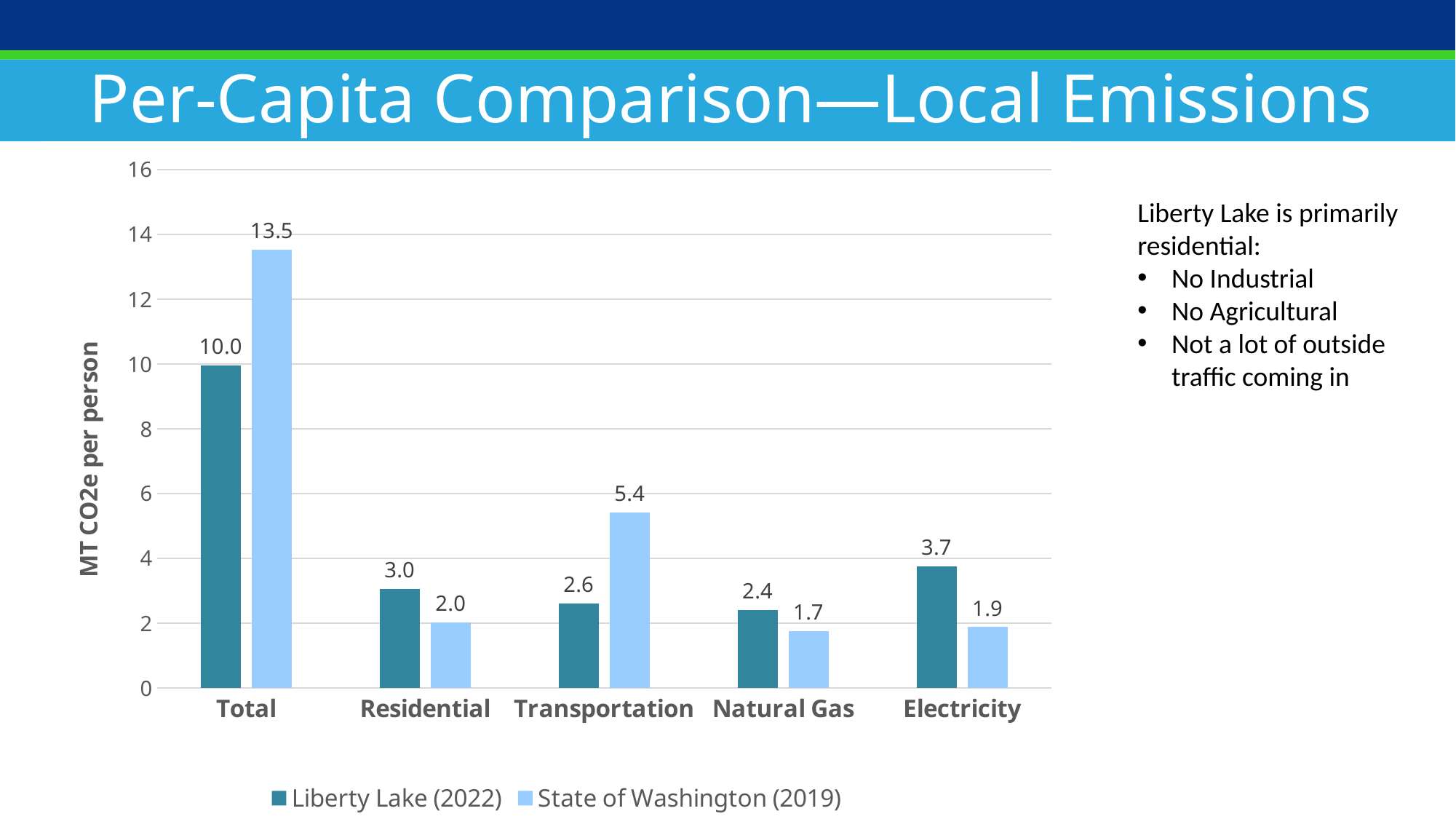
For Residential, which series has the larger value: Liberty Lake (2022) or State of Washington (2019)? Liberty Lake (2022) What is the State of Washington (2019) value for Natural Gas? 1.7 Which category has the highest State of Washington (2019) value? Total How many categories are shown on the x axis? 5 What is the State of Washington (2019) value for Transportation? 5.4 What is the label of the vertical axis? MT CO2e per person What is the Liberty Lake (2022) value for Total? 10.0 How many series does the legend list? 2 Excluding Total, which category has the lowest Liberty Lake (2022) value? Natural Gas What is the difference between the State of Washington (2019) and Liberty Lake (2022) values for Total? 3.5 What is the Liberty Lake (2022) value for Electricity? 3.7 What kind of chart is shown on the slide? Bar chart